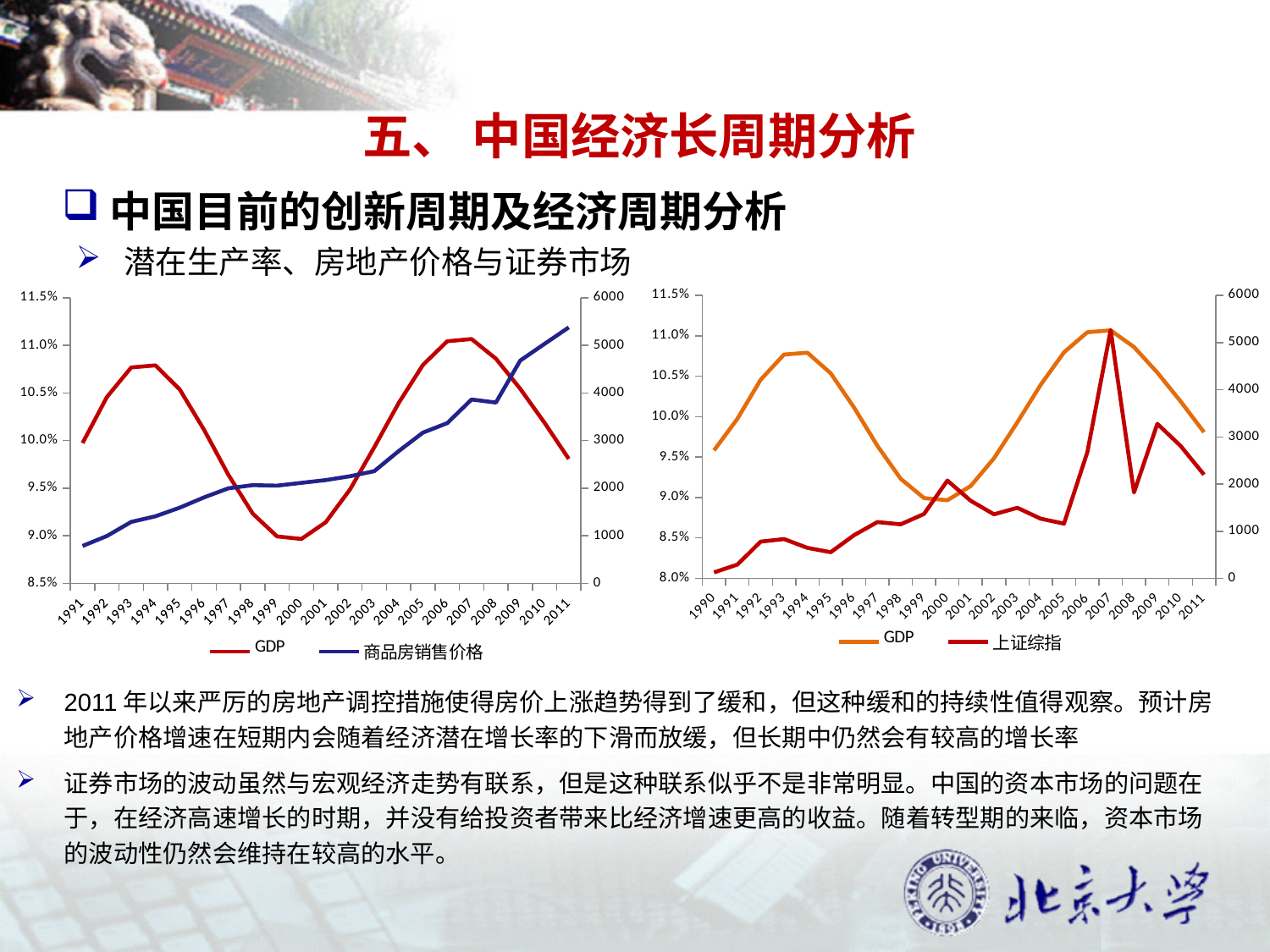
In the right chart, is the GDP value for 1993 greater or less than 10.5%? greater In the left chart, is the 商品房销售价格 value for 2011 greater or less than 5000? greater In the left chart, in which year is the 商品房销售价格 line at its lowest? 1991 How many years are shown on the x axis of the left chart? 21 How many series does the legend of the left chart list? 2 What are the two series named in the legend of the right chart? GDP and 上证综指 In the right chart, in which year does the 上证综指 line peak? 2007 What kind of chart is the left chart on the slide? line chart In the left chart, does the 商品房销售价格 line generally rise or fall from 1991 to 2011? rise In the right chart, is the 上证综指 value for 2008 greater or less than 2000? less In the left chart, in which year does the GDP line reach its highest point? 2007 How many years are shown on the x axis of the right chart? 22